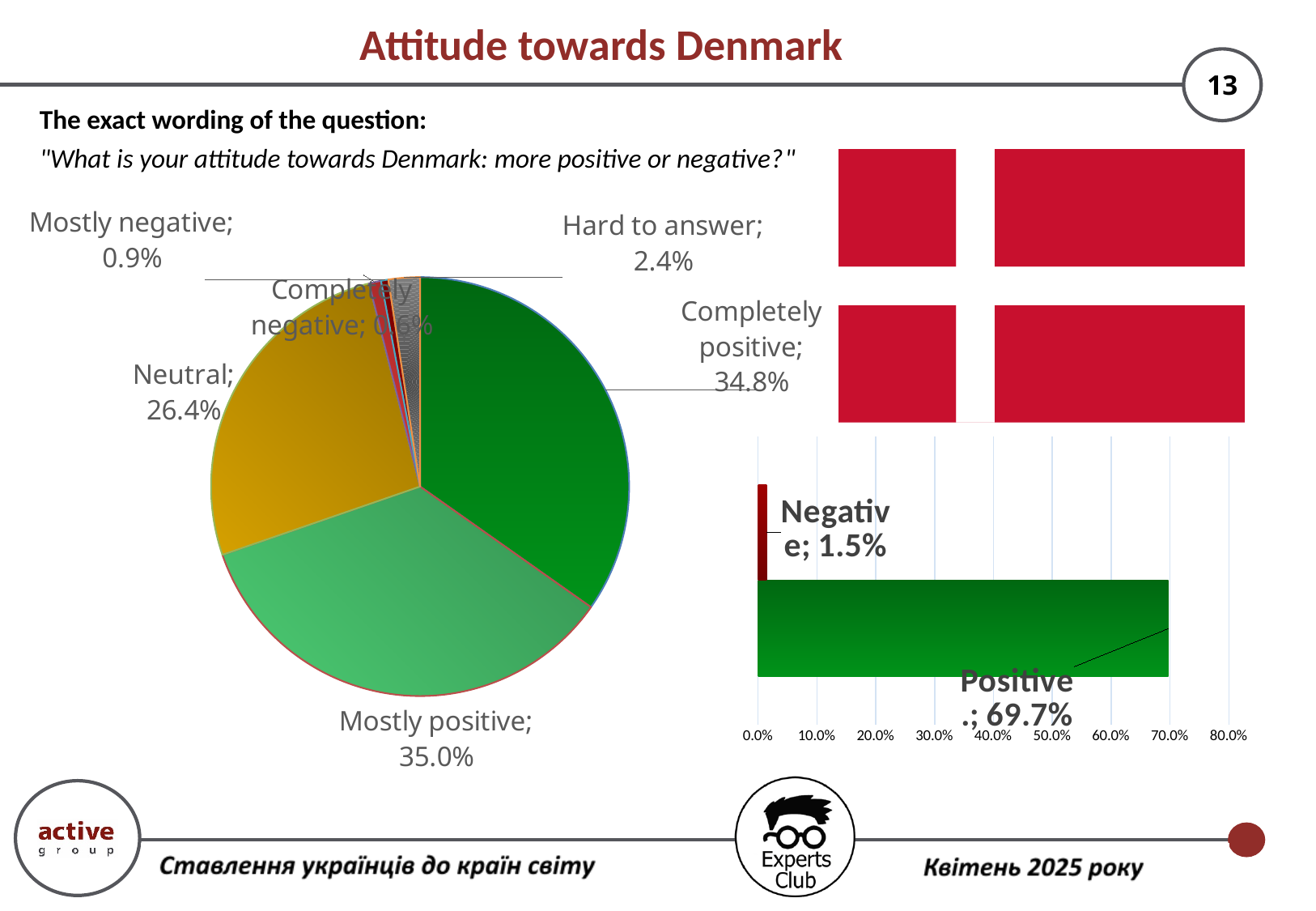
In the pie chart, what is the value for "Neutral"? 26.4% In the pie chart, what is the difference between "Mostly positive" and "Neutral"? 8.6% In the bar chart on the right, is the value for "Positive" greater or less than 60.0%? greater In the pie chart, what is the value for "Mostly negative"? 0.9% In the pie chart, what is the value for "Hard to answer"? 2.4% In the bar chart on the right, what is the difference between "Positive" and "Negative"? 68.2% In the pie chart, which is larger: "Completely positive" or "Neutral"? Completely positive What kind of chart is the chart on the left of the slide? Pie chart In the pie chart, what share of respondents answered "Mostly positive"? 35.0% In the bar chart on the right, what is the value for "Negative"? 1.5% In the bar chart on the right, what is the value for "Positive"? 69.7% How many slices does the pie chart on the left have? 6